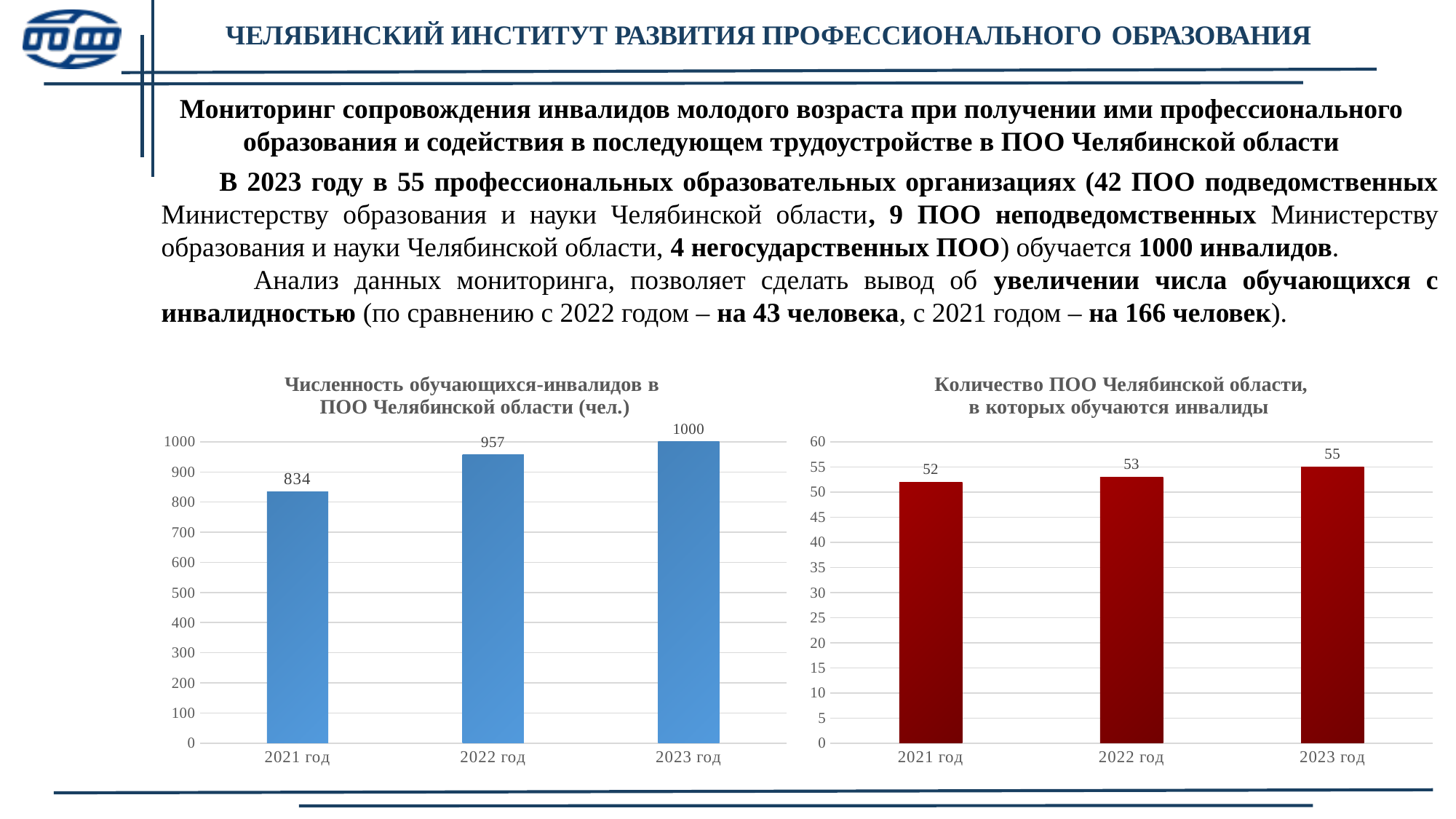
In the right chart 'Количество ПОО Челябинской области, в которых обучаются инвалиды', what is the value for 2021 год? 52 In the left chart 'Численность обучающихся-инвалидов в ПОО Челябинской области (чел.)', what is the difference between the values for 2023 год and 2021 год? 166 In the right chart 'Количество ПОО Челябинской области, в которых обучаются инвалиды', what is the difference between the values for 2023 год and 2022 год? 2 In the left chart 'Численность обучающихся-инвалидов в ПОО Челябинской области (чел.)', what is the value for 2021 год? 834 In the left chart 'Численность обучающихся-инвалидов в ПОО Челябинской области (чел.)', what is the value for 2022 год? 957 In the left chart 'Численность обучающихся-инвалидов в ПОО Челябинской области (чел.)', which year has the highest value? 2023 год In the right chart 'Количество ПОО Челябинской области, в которых обучаются инвалиды', which year has the lowest value? 2021 год In the right chart 'Количество ПОО Челябинской области, в которых обучаются инвалиды', do the values rise or fall from 2021 год to 2023 год? Rise In the right chart 'Количество ПОО Челябинской области, в которых обучаются инвалиды', what is the value for 2023 год? 55 What type of chart is the left chart 'Численность обучающихся-инвалидов в ПОО Челябинской области (чел.)'? Bar chart In the left chart 'Численность обучающихся-инвалидов в ПОО Челябинской области (чел.)', which is larger: the value for 2022 год or 2021 год? 2022 год How many bars are shown in the right chart 'Количество ПОО Челябинской области, в которых обучаются инвалиды'? 3